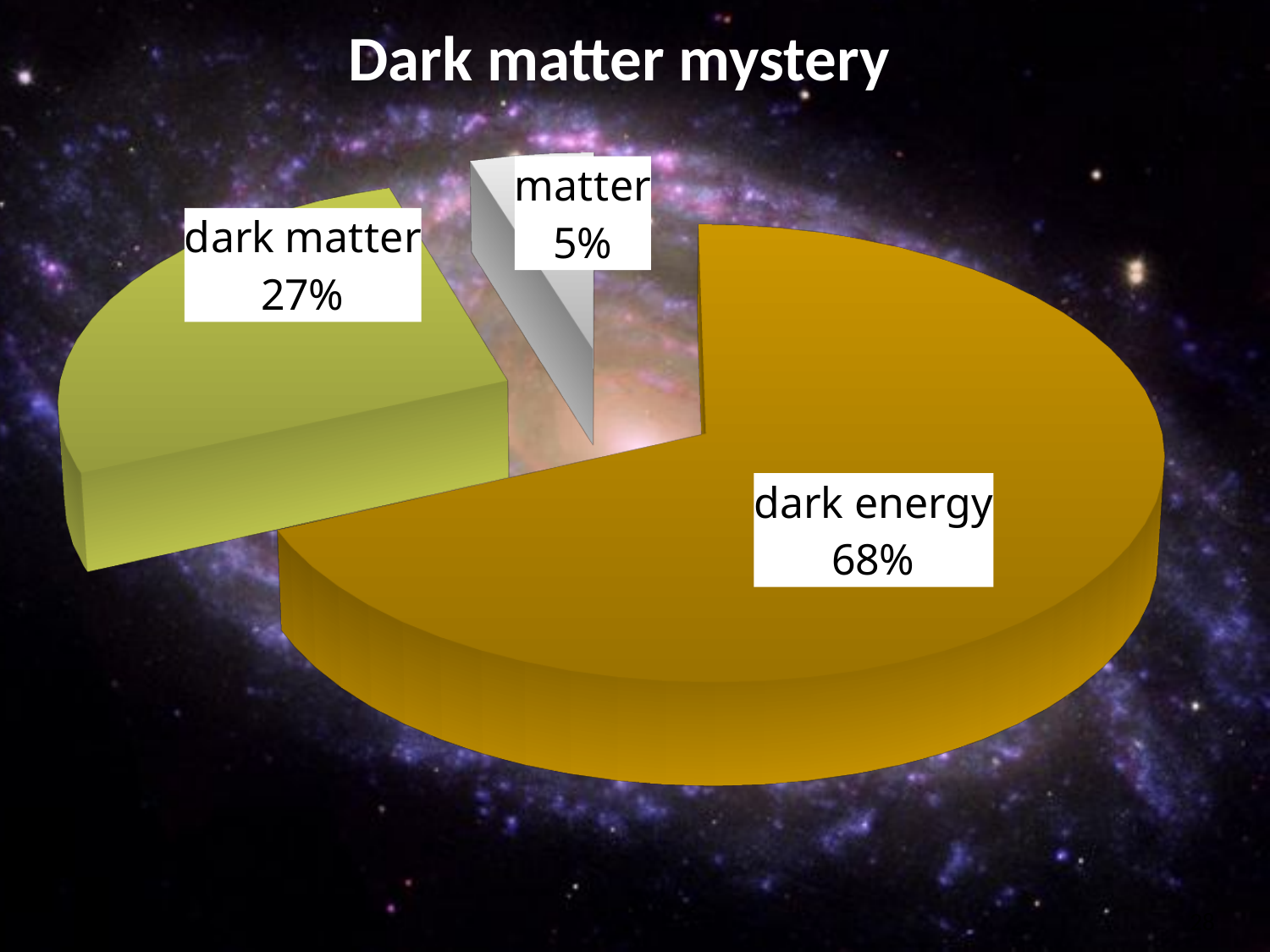
What colour is the dark energy slice? gold/orange What percentage of the pie is dark matter? 27% What percentage of the pie is dark energy? 68% What kind of chart is shown on the slide? pie chart What percentage of the pie is matter? 5% Which slice of the pie is the largest? dark energy How many slices does the pie chart have? 3 Which is larger, the dark matter slice or the matter slice? dark matter Which slice of the pie is the smallest? matter What is the difference in percentage points between dark matter and matter? 22 What is the difference in percentage points between dark energy and dark matter? 41 What is the title of the chart? Dark matter mystery